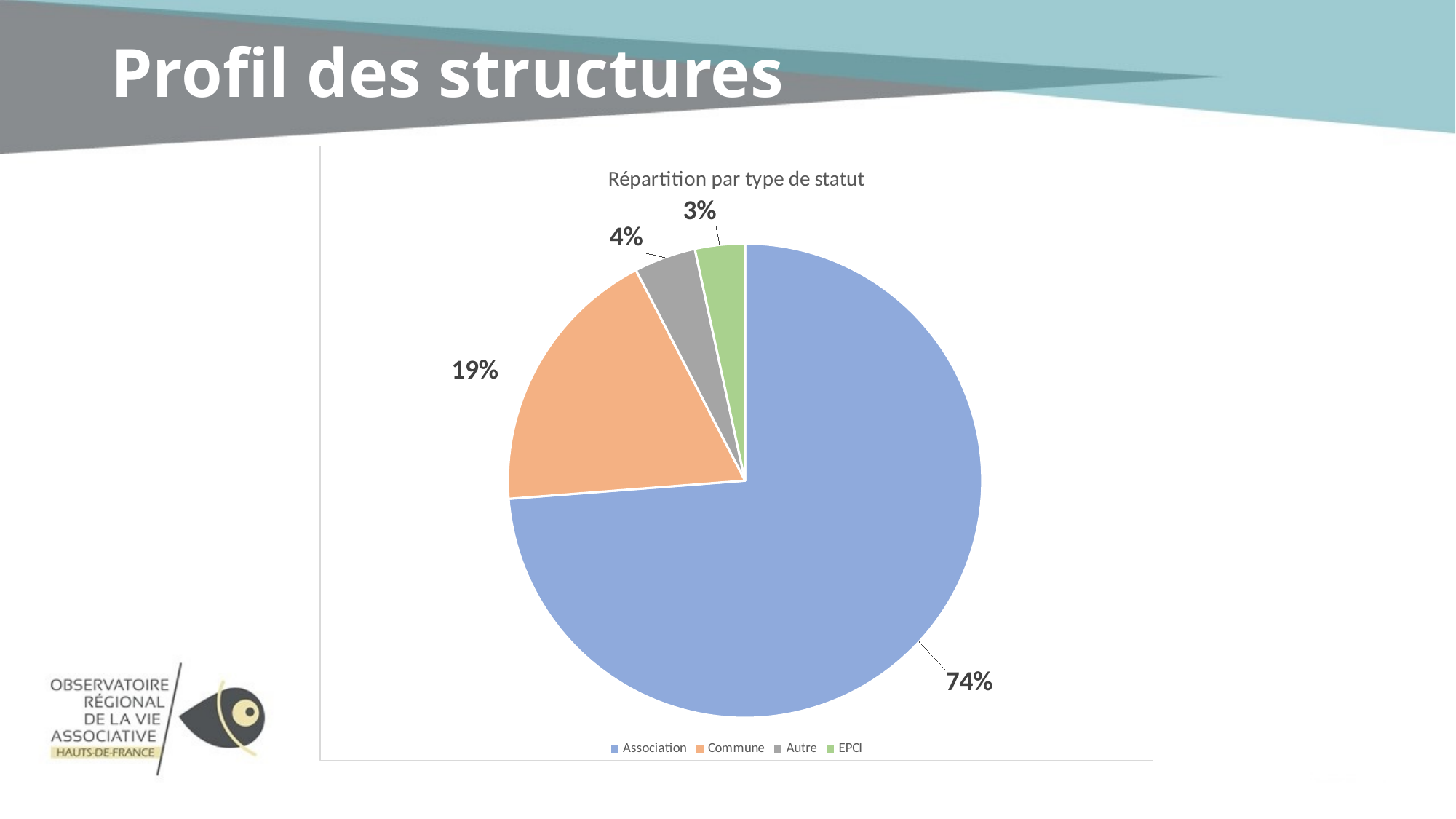
What is the value shown for EPCI? 3% What kind of chart is shown on the slide? pie chart What share of the pie does Commune represent? 19% What share of the pie does Association represent? 74% Which category has the largest slice of the pie? Association What is the value shown for Autre? 4% What is the title of the chart? Répartition par type de statut How many categories does the pie chart show? 4 What colour is the slice for Commune? orange Which category has the smallest slice of the pie? EPCI What is the difference between the shares of Association and Commune? 55% Which is larger, the share for Commune or the share for Autre? Commune